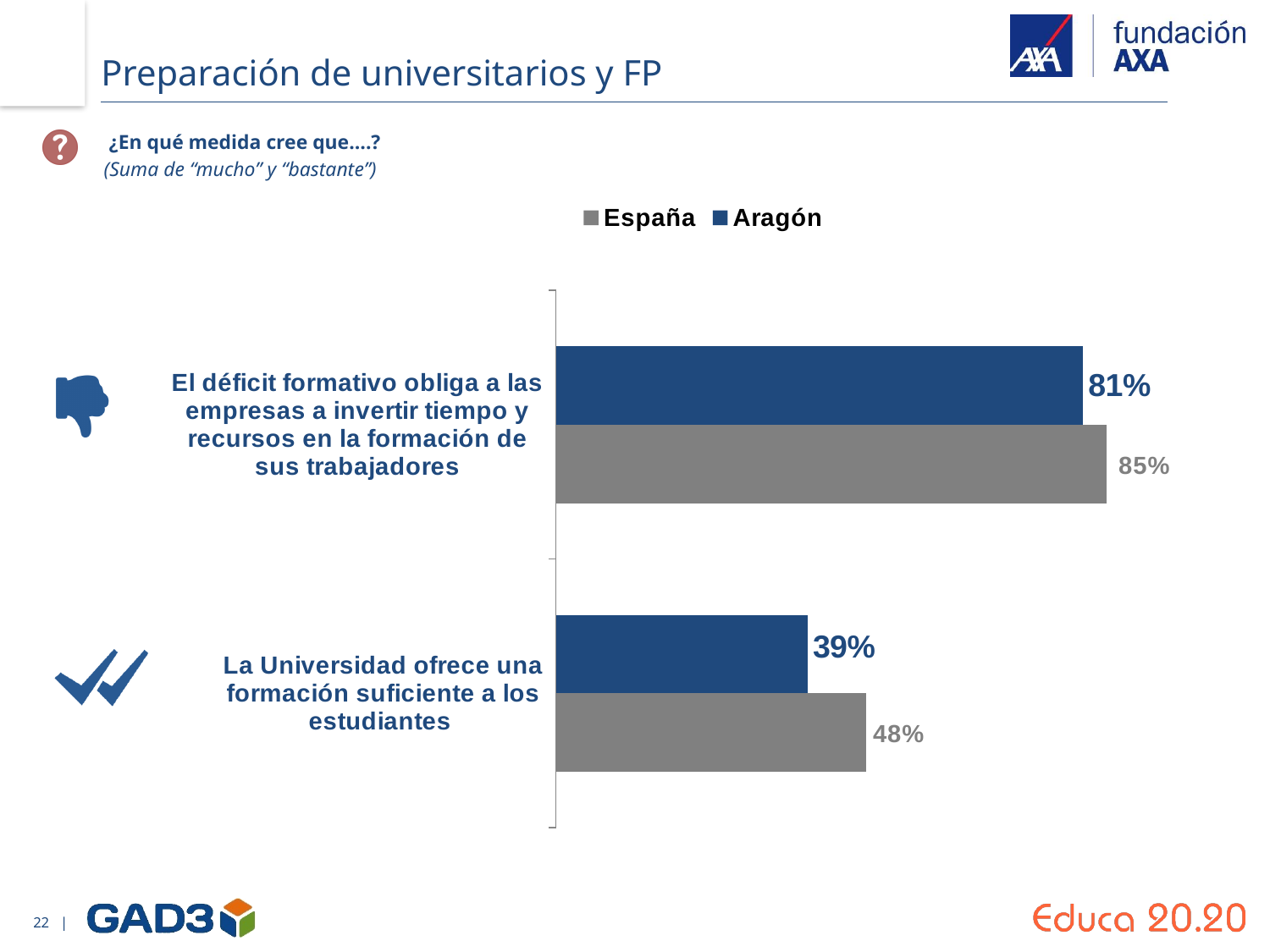
What is the España value for "El déficit formativo obliga a las empresas a invertir tiempo y recursos en la formación de sus trabajadores"? 85% What is the España value for "La Universidad ofrece una formación suficiente a los estudiantes"? 48% How many categories are shown in the chart? 2 How many series does the legend list? 2 What is the difference between the España and Aragón values for "La Universidad ofrece una formación suficiente a los estudiantes"? 9% Which category has the highest Aragón value? El déficit formativo obliga a las empresas a invertir tiempo y recursos en la formación de sus trabajadores Which series has the higher value for "La Universidad ofrece una formación suficiente a los estudiantes", España or Aragón? España What is the difference between the España and Aragón values for "El déficit formativo obliga a las empresas a invertir tiempo y recursos en la formación de sus trabajadores"? 4% What kind of chart is shown on the slide? Bar chart What is the Aragón value for "El déficit formativo obliga a las empresas a invertir tiempo y recursos en la formación de sus trabajadores"? 81% Which category has the lowest España value? La Universidad ofrece una formación suficiente a los estudiantes What is the Aragón value for "La Universidad ofrece una formación suficiente a los estudiantes"? 39%